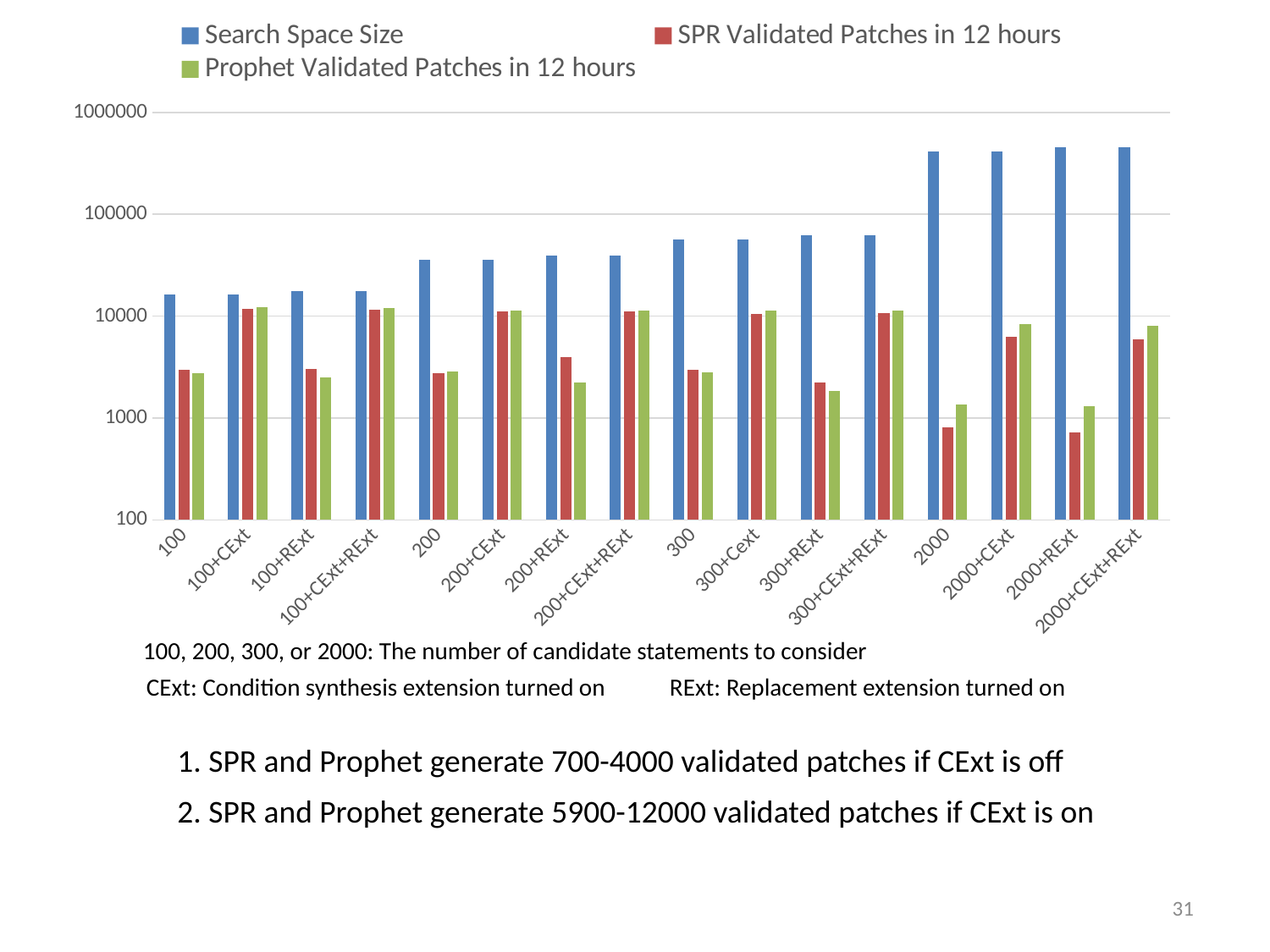
Is the value of Prophet Validated Patches in 12 hours for 200+RExt greater or less than 10000? less Which has more SPR Validated Patches in 12 hours, 100 or 100+CExt? 100+CExt How many categories are shown along the x axis? 16 Is the Search Space Size for 2000 greater or less than 100000? greater Is the Search Space Size for 100 greater or less than 10000? greater Which has a larger Search Space Size, 100 or 2000? 2000 How many series does the legend list? 3 Does the Search Space Size generally rise or fall moving from 100 to 2000+CExt+RExt along the x axis? rise Which colour represents Search Space Size in the legend? Blue What kind of chart is shown on the slide? Bar chart